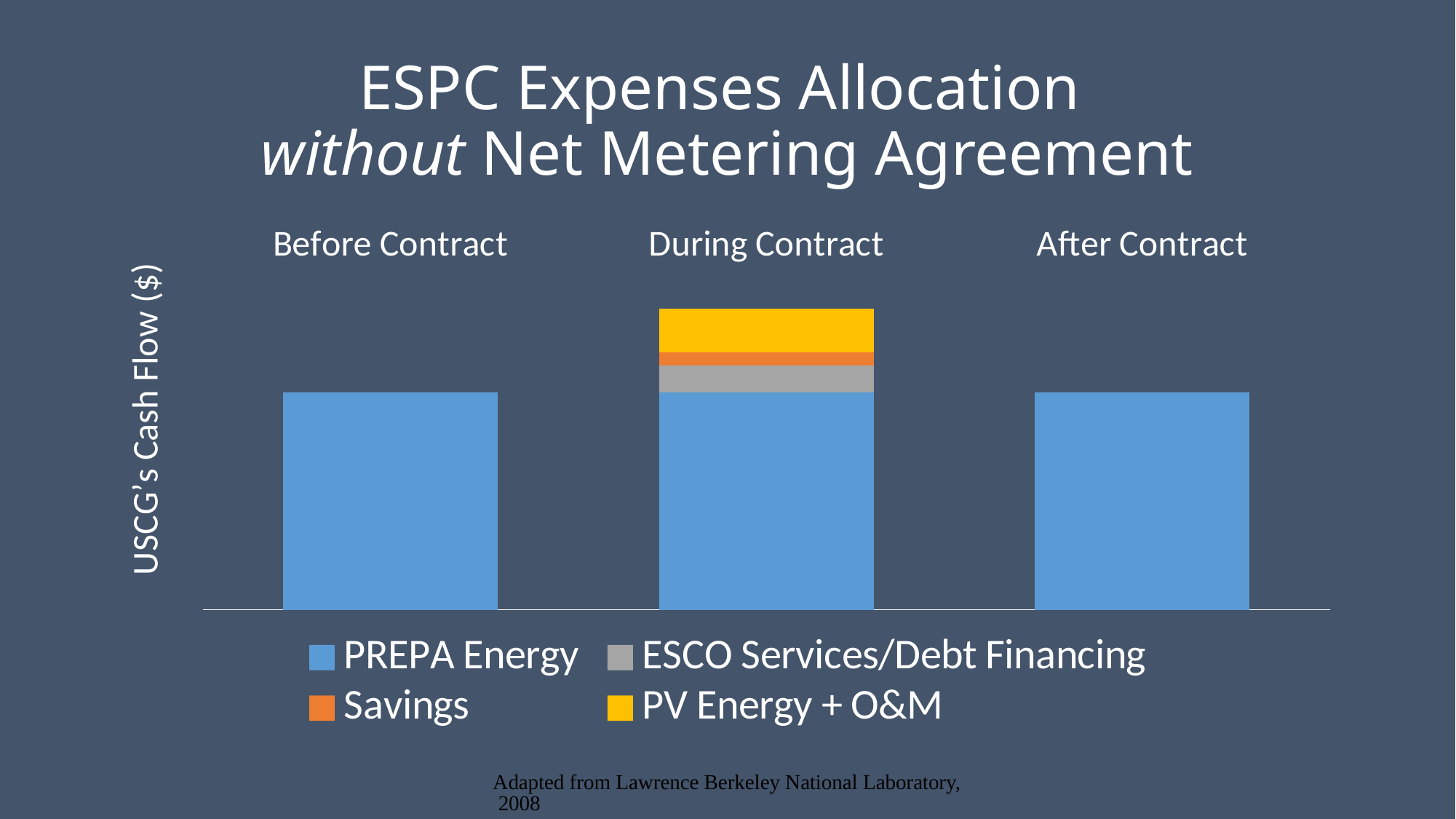
Which series is shown in yellow in the legend? PV Energy + O&M Which category's bar contains all four series? During Contract What kind of chart is shown on the slide? Stacked bar chart How many series does the legend list? 4 Which series is shown in grey in the legend? ESCO Services/Debt Financing Which bar is taller, After Contract or During Contract? During Contract Which bar is taller, Before Contract or During Contract? During Contract How many categories are shown along the x axis? 3 Which category has the tallest stacked bar? During Contract